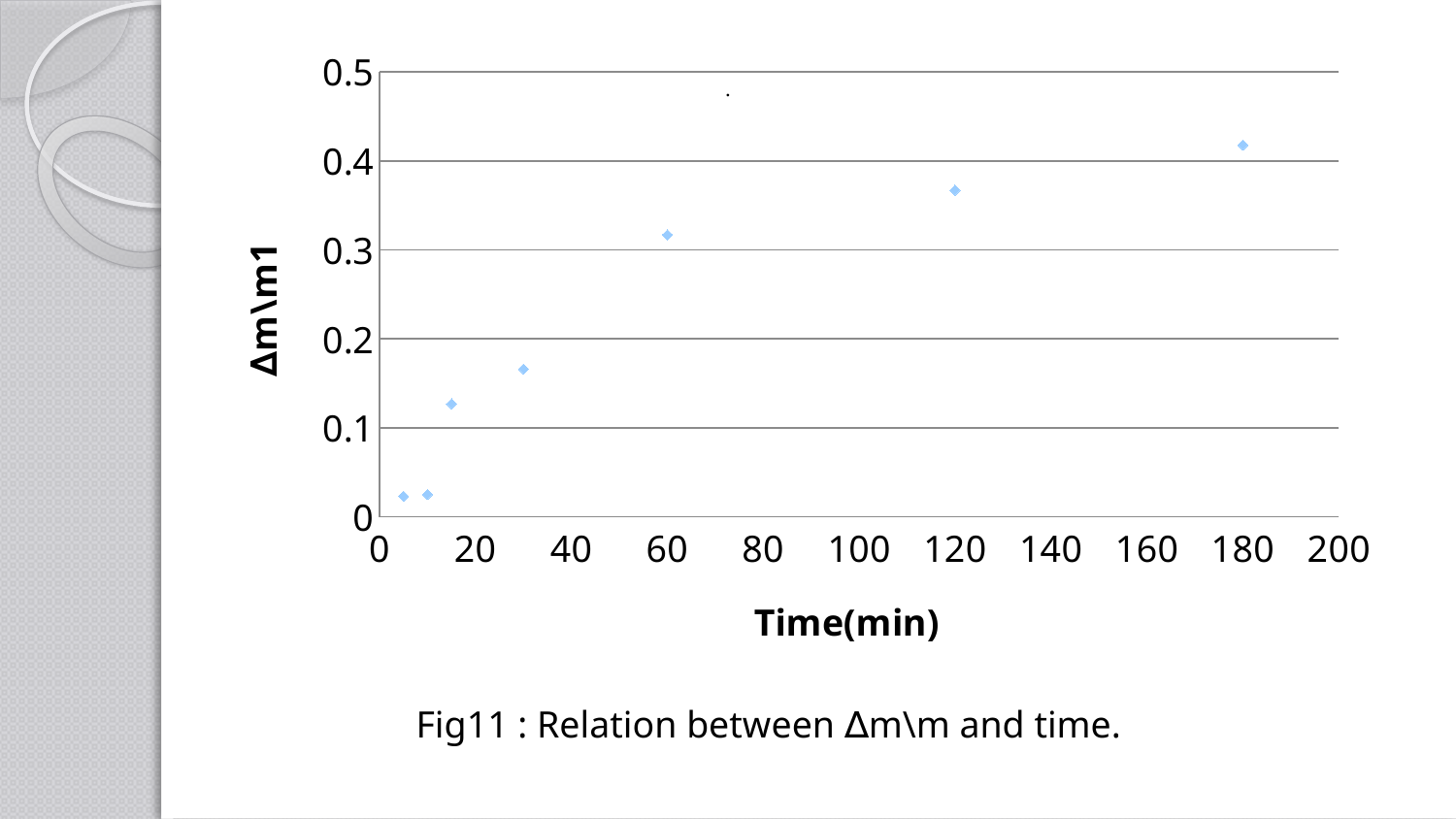
Which has the larger Δm\m1 value, the point at 60 min or the point at 120 min? 120 min Is the value at 180 min greater or less than 0.4? greater At which time (in minutes) is the plotted Δm\m1 value highest? 180 Do the Δm\m1 values rise or fall as time increases along the x axis? rise Is the value at 5 min greater or less than 0.1? less Is the value at 120 min greater or less than 0.4? less What is the label of the x axis? Time(min) What is the figure caption below the chart? Fig11 : Relation between Δm\m and time. What kind of chart is shown on the slide? scatter chart